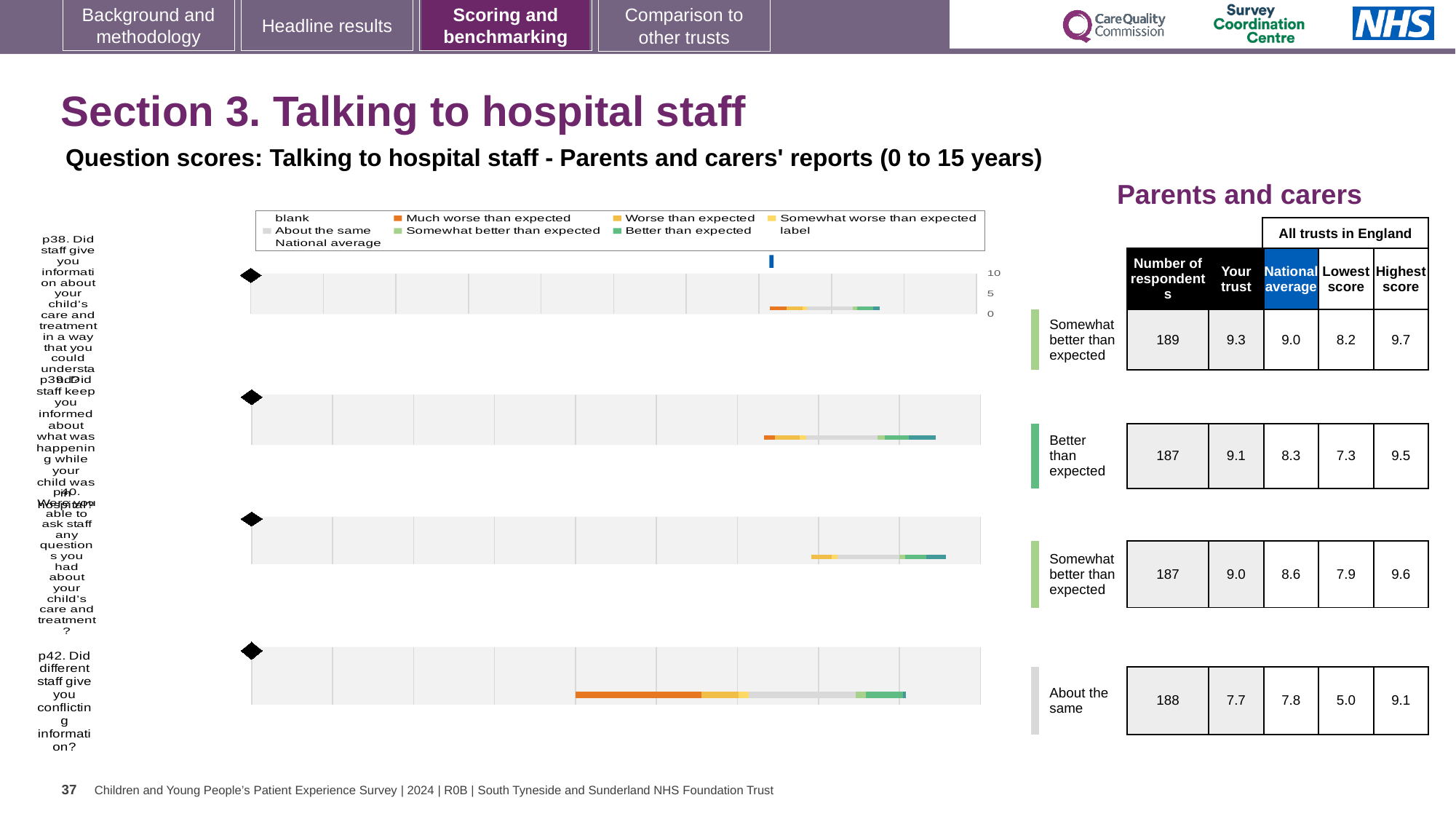
For question p38, what is the difference between the 'Your trust' score and the national average? 0.3 What is the lowest score across all trusts in England for question p42? 5.0 What kind of chart is used to show the question scores on this slide? bar chart For question p42, which is larger: the 'Your trust' score or the national average? National average For question p42 (conflicting information), what is the national average score shown in the table? 7.8 What benchmark category is shown for question p39 (keeping you informed)? Better than expected How many survey questions (p38, p39, p40, p42) are plotted on this slide? 4 Which question has the highest 'Your trust' score in the table? p38 Which question has the lowest 'Your trust' score in the table? p42 For question p39 (keeping you informed), how many respondents are shown in the table? 187 For question p38 (information about your child's care and treatment), what is the 'Your trust' score shown in the table? 9.3 In the legend, which colour represents 'Much worse than expected'? Orange